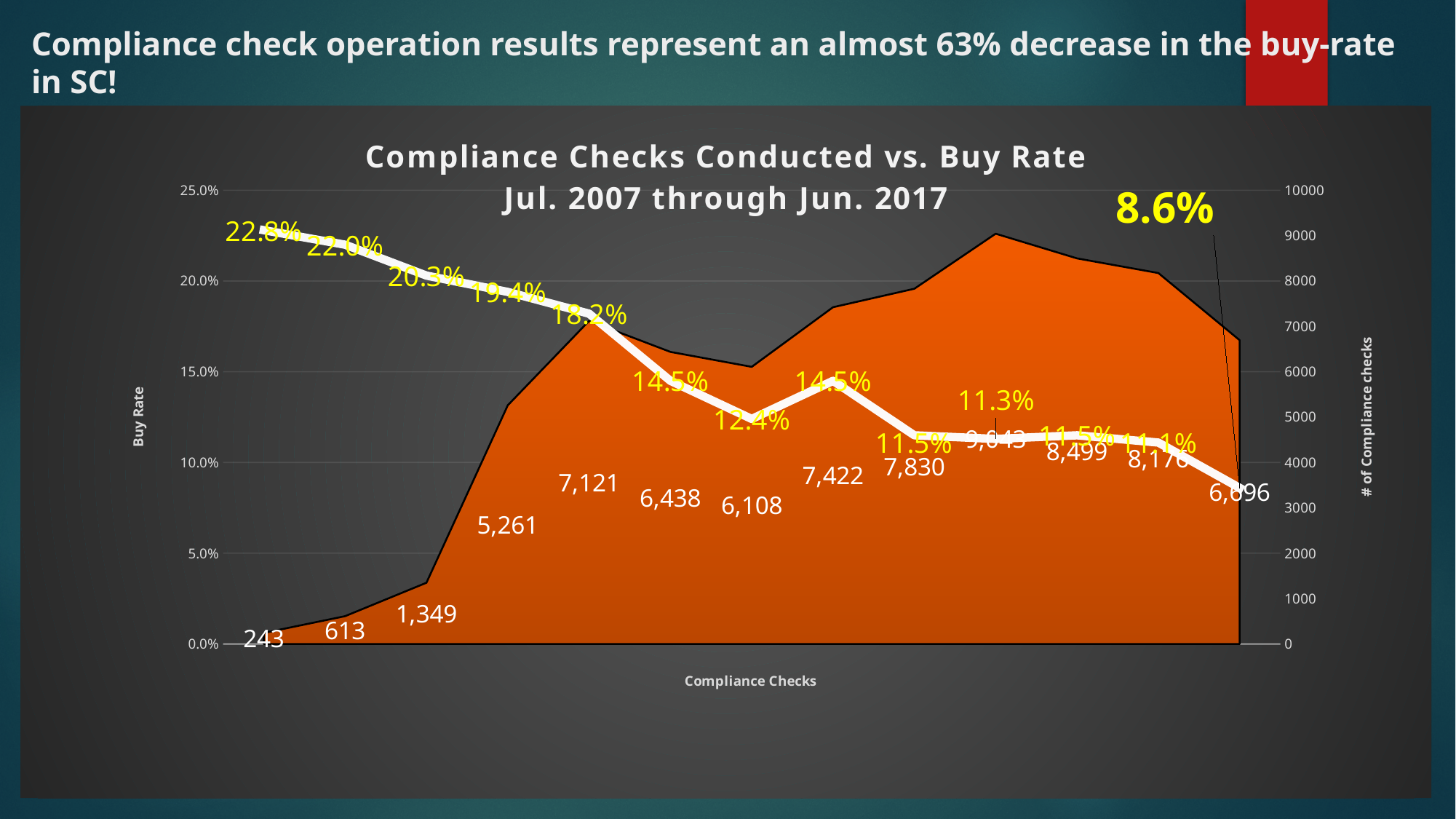
What is the label on the right-hand vertical axis? # of Compliance checks What is the lowest number of compliance checks shown on the chart? 243 Does the buy rate line generally rise or fall from left to right? Fall What is the buy rate at the first (leftmost) point of the line? 22.8% How many data points are plotted on the buy rate line? 13 By how many percentage points does the buy rate fall from the first point (22.8%) to the last point (8.6%)? 14.2 percentage points What kind of chart is shown on the slide? A combination chart with an area series and a line series What is the buy rate at the last (rightmost) point of the line? 8.6% What is the lowest buy rate shown on the chart? 8.6% What is the title of the chart? Compliance Checks Conducted vs. Buy Rate Jul. 2007 through Jun. 2017 What is the highest buy rate shown on the chart? 22.8% What is the number of compliance checks at the last (rightmost) point of the area? 6,696